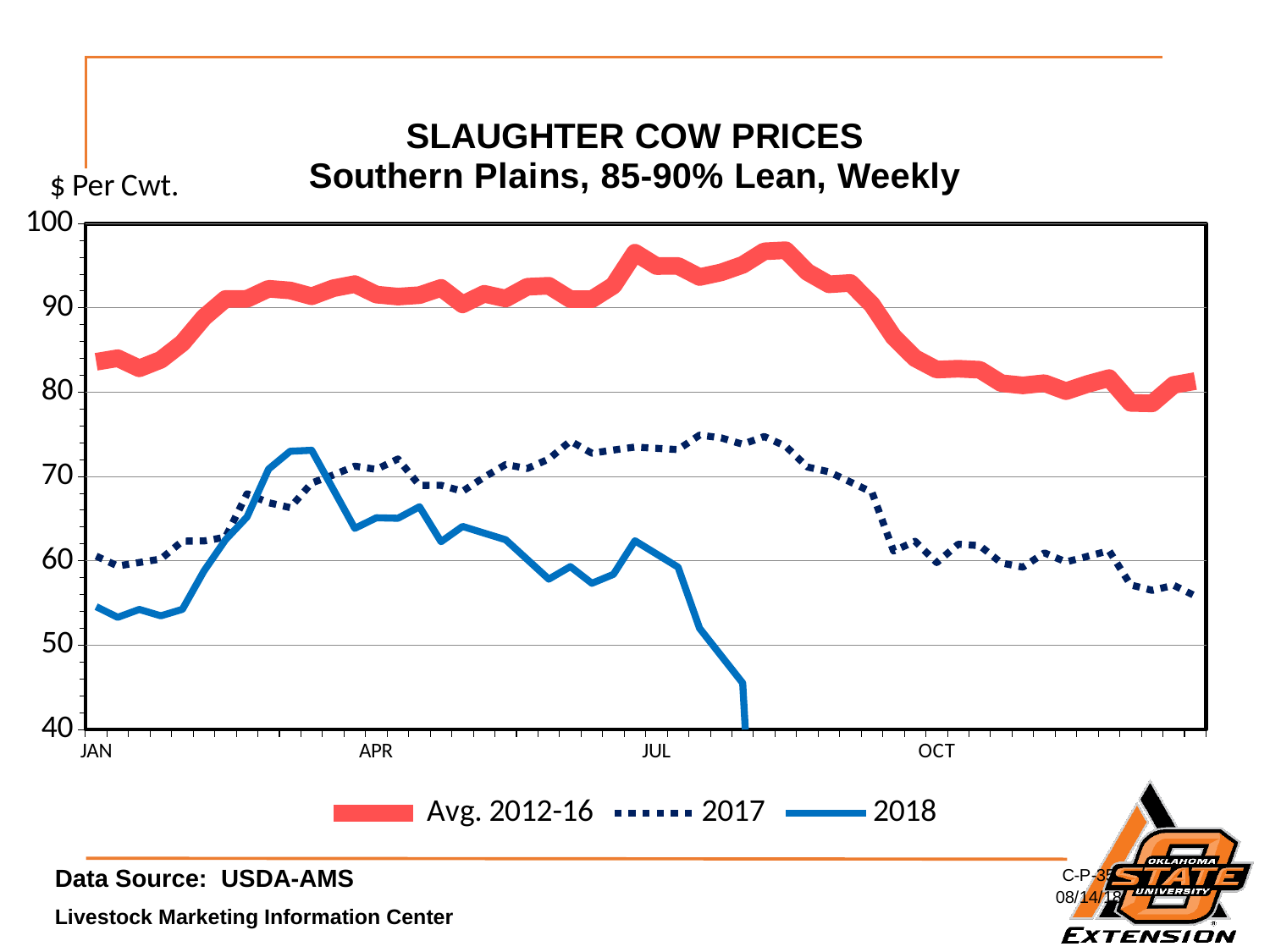
Is the 2018 value in JAN greater or less than 50? greater What are the three series listed in the legend? Avg. 2012-16, 2017, 2018 Is the Avg. 2012-16 value in JAN greater or less than 80? greater Is the 2017 value in JUL greater or less than 70? greater What is the label on the y axis of the chart? $ Per Cwt. Does the 2018 line rise or fall from JUL to its last plotted point? fall In JAN, which is higher, the 2017 value or the 2018 value? 2017 What kind of chart is shown on the slide? line chart Which series has the highest values across the whole chart? Avg. 2012-16 How many series does the legend list? 3 Does the Avg. 2012-16 line rise or fall from JUL to OCT? fall